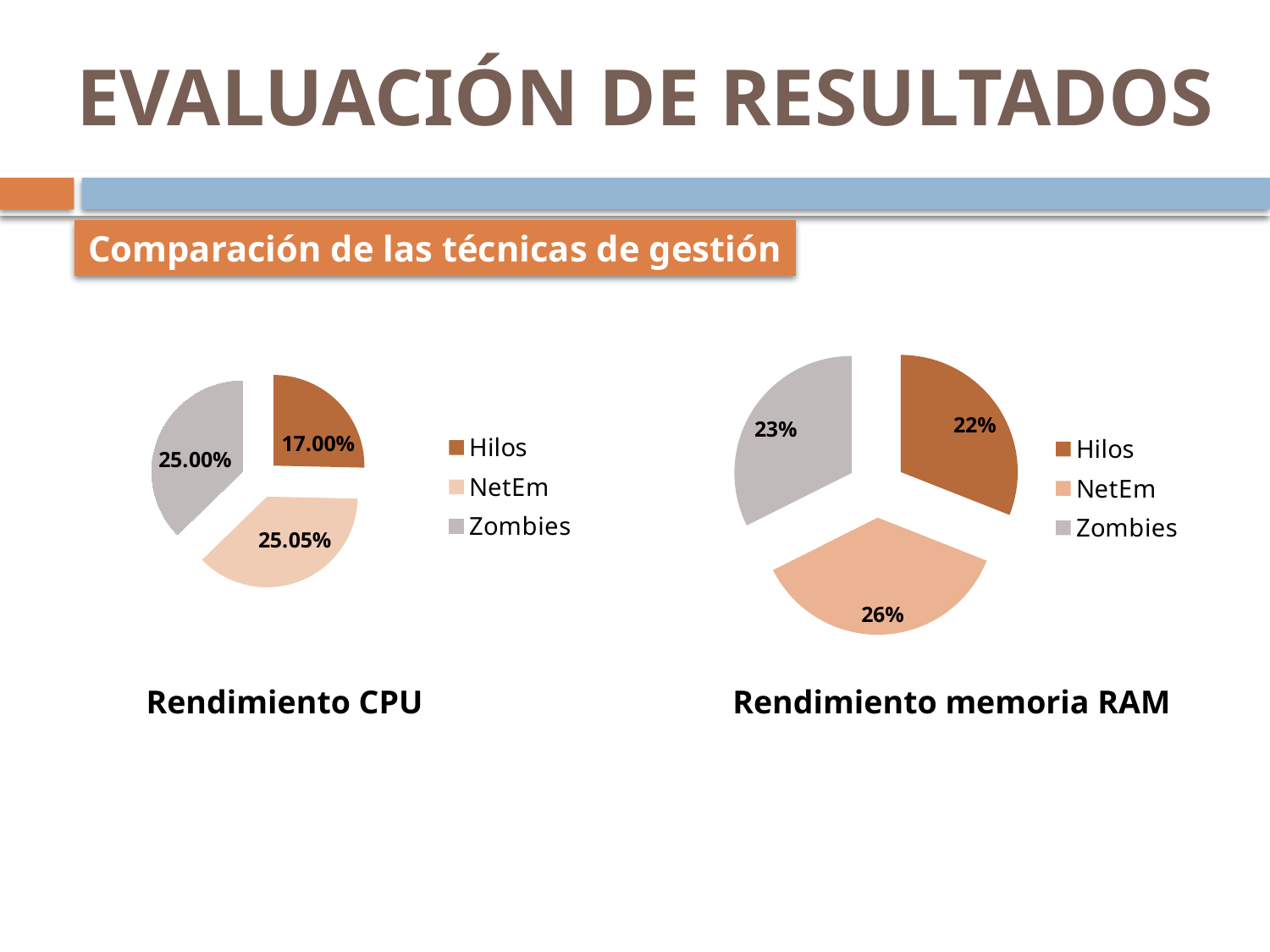
In the Rendimiento memoria RAM chart, what is the difference between the NetEm value and the Hilos value? 4% In the Rendimiento memoria RAM chart, what is the value shown for NetEm? 26% In the Rendimiento CPU chart, which is larger, the Hilos slice or the Zombies slice? Zombies In the Rendimiento CPU chart, what is the value shown for NetEm? 25.05% In the Rendimiento CPU chart, what is the value shown for Hilos? 17.00% What kind of chart is the Rendimiento CPU chart? Pie chart What are the three legend entries in the Rendimiento CPU chart? Hilos, NetEm, Zombies How many categories are shown in the Rendimiento memoria RAM chart? 3 In the Rendimiento memoria RAM chart, which category has the largest slice? NetEm In the Rendimiento CPU chart, what is the difference between the NetEm value and the Hilos value? 8.05% In the Rendimiento CPU chart, which category has the smallest slice? Hilos In the Rendimiento memoria RAM chart, what is the value shown for Zombies? 23%